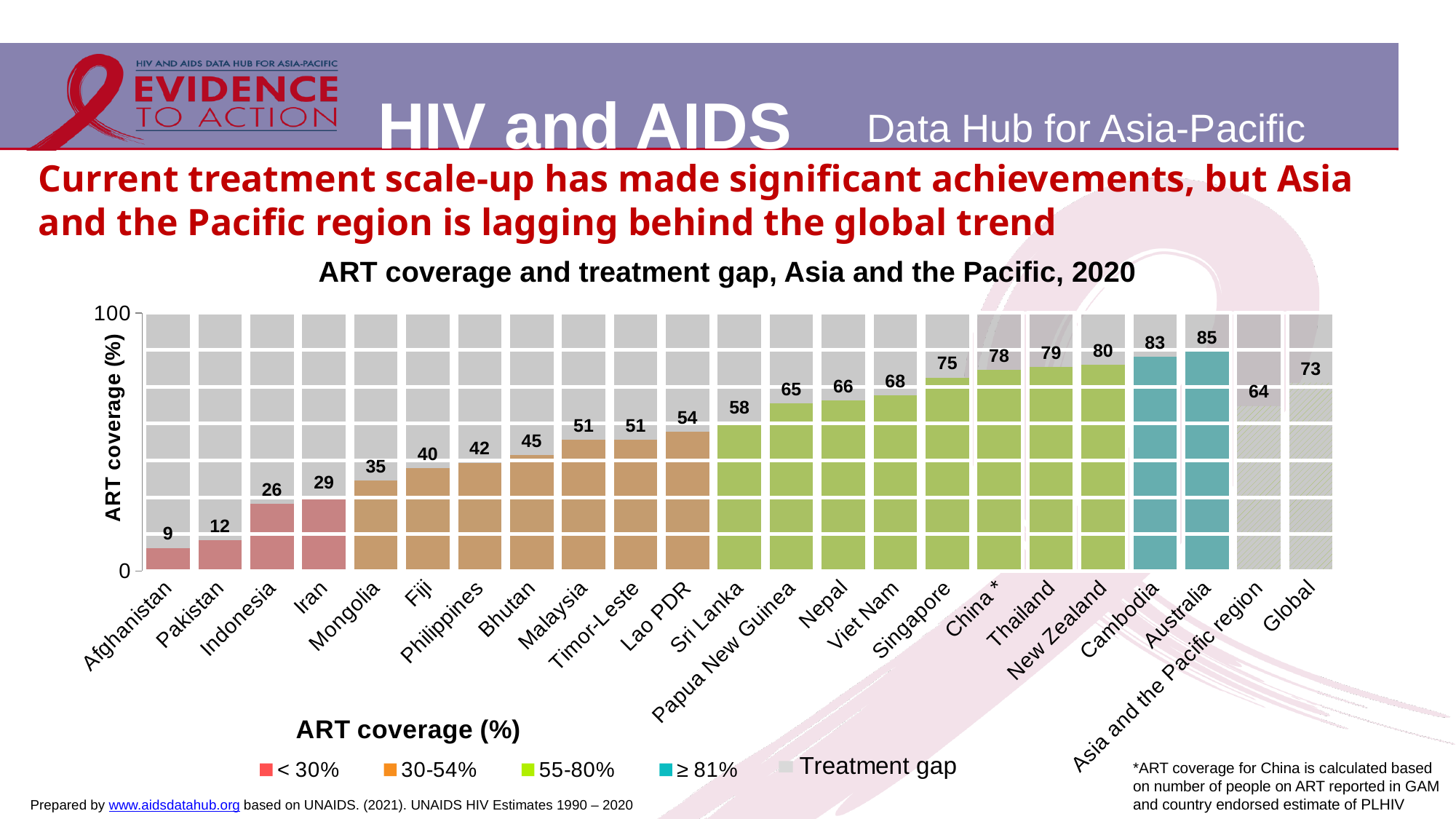
Which has higher ART coverage, Thailand or Singapore? Thailand Which country has the highest ART coverage in the chart? Australia How many entries does the legend list? 5 What is the ART coverage value shown for the Global bar? 73 What is the ART coverage value shown for Cambodia? 83 What type of chart is shown on the slide? Bar chart What is the ART coverage value shown for Afghanistan? 9 What is the ART coverage value shown for Australia? 85 Which country has the lowest ART coverage in the chart? Afghanistan What is the difference in ART coverage between Australia and Afghanistan? 76 What is the difference between the Global ART coverage and the Asia and the Pacific region ART coverage? 9 How many bars (countries and regions) are shown in the chart? 23